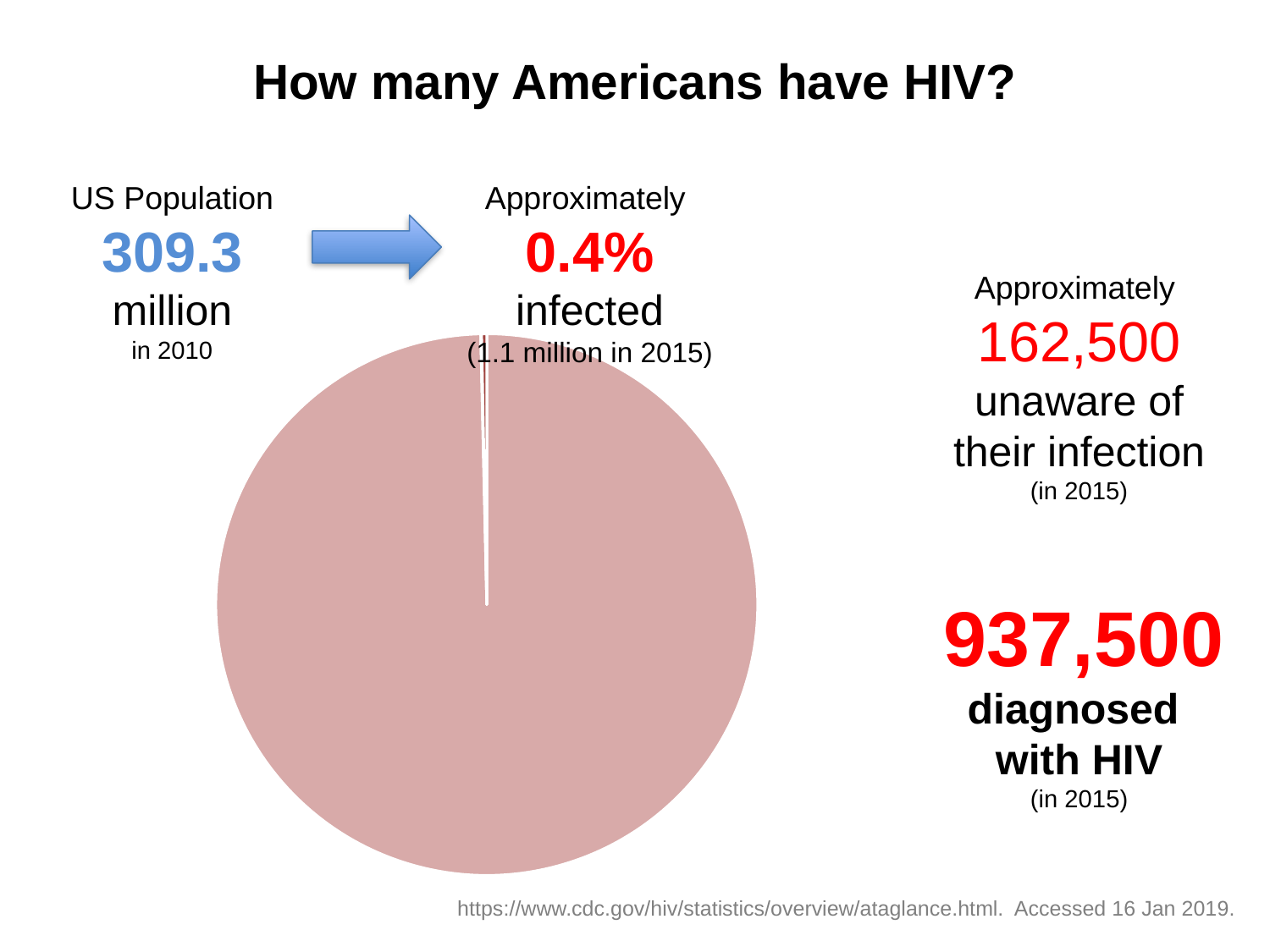
According to the slide, what US population does the pie chart represent? 309.3 million According to the slide, approximately how many Americans were unaware of their HIV infection in 2015? 162,500 What colour is the large slice of the pie chart? pink What share of the pie does the slice representing Americans infected with HIV take up? 0.4% According to the slide, how many Americans were infected with HIV in 2015? 1.1 million What kind of chart is shown on the slide? pie chart What is the title of the slide containing the pie chart? How many Americans have HIV? Is the slice representing Americans infected with HIV larger or smaller than the remaining slice of the pie? smaller How many slices does the pie chart have? 3 According to the slide, how many Americans were diagnosed with HIV in 2015? 937,500